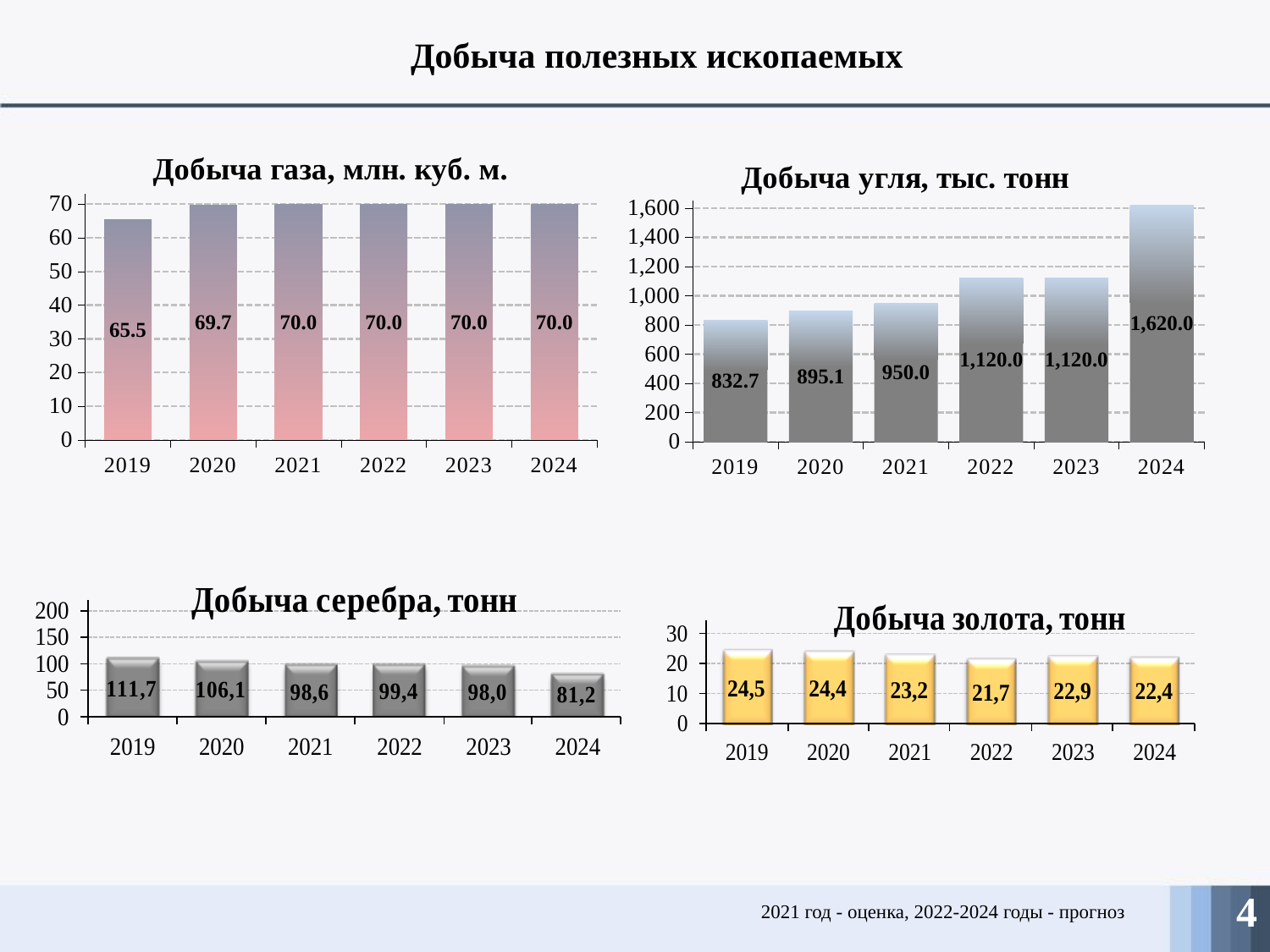
In the chart "Добыча угля, тыс. тонн", is the value for 2021 greater or less than 1,000? less In the chart "Добыча угля, тыс. тонн", which year has the highest value? 2024 In the chart "Добыча угля, тыс. тонн", what is the value for 2024? 1,620.0 How many years are shown on the x axis of the chart "Добыча газа, млн. куб. м."? 6 In the chart "Добыча золота, тонн", which year has the lowest value? 2022 In the chart "Добыча угля, тыс. тонн", do the values generally rise or fall from 2019 to 2024? rise What kind of chart is "Добыча серебра, тонн"? bar chart In the chart "Добыча газа, млн. куб. м.", what is the value for 2019? 65.5 In the chart "Добыча золота, тонн", which is larger, the value for 2019 or the value for 2023? 2019 In the chart "Добыча серебра, тонн", what is the difference between the 2019 value and the 2024 value? 30,5 In the chart "Добыча угля, тыс. тонн", what is the difference between the 2024 value and the 2023 value? 500.0 In the chart "Добыча серебра, тонн", what is the value for 2022? 99,4